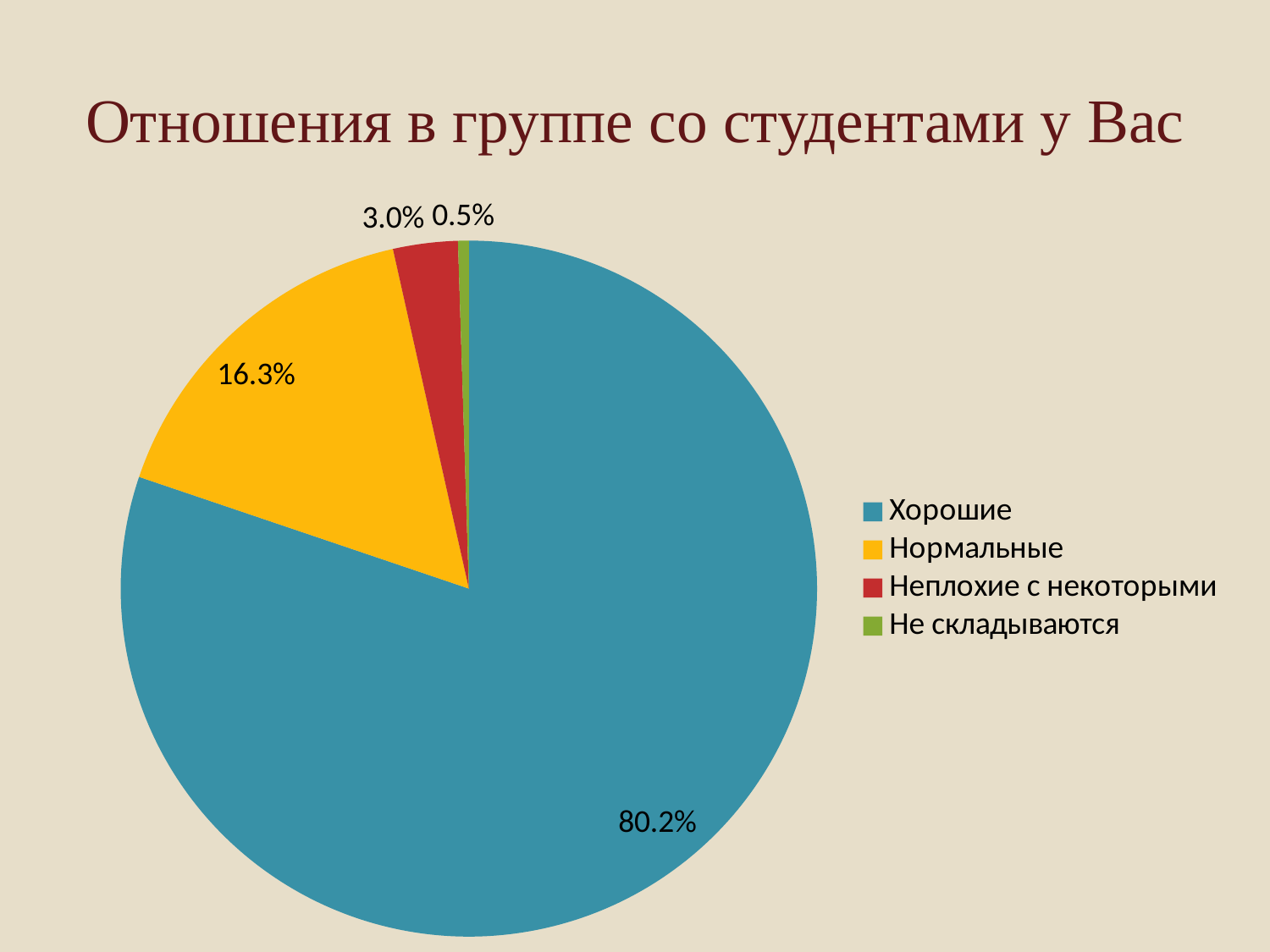
Which category has the smallest slice? Не складываются What share of the pie does the "Нормальные" slice have? 16.3% What is the difference between the "Хорошие" and "Нормальные" shares? 63.9% How many categories does the pie chart have? 4 What share of the pie does the "Хорошие" slice have? 80.2% What is the value for "Неплохие с некоторыми"? 3.0% What kind of chart is shown on the slide? pie chart Which is larger, the "Нормальные" slice or the "Неплохие с некоторыми" slice? Нормальные What colour is the "Нормальные" slice? yellow What is the value for "Не складываются"? 0.5% Which category has the largest slice? Хорошие What is the title of the slide? Отношения в группе со студентами у Вас